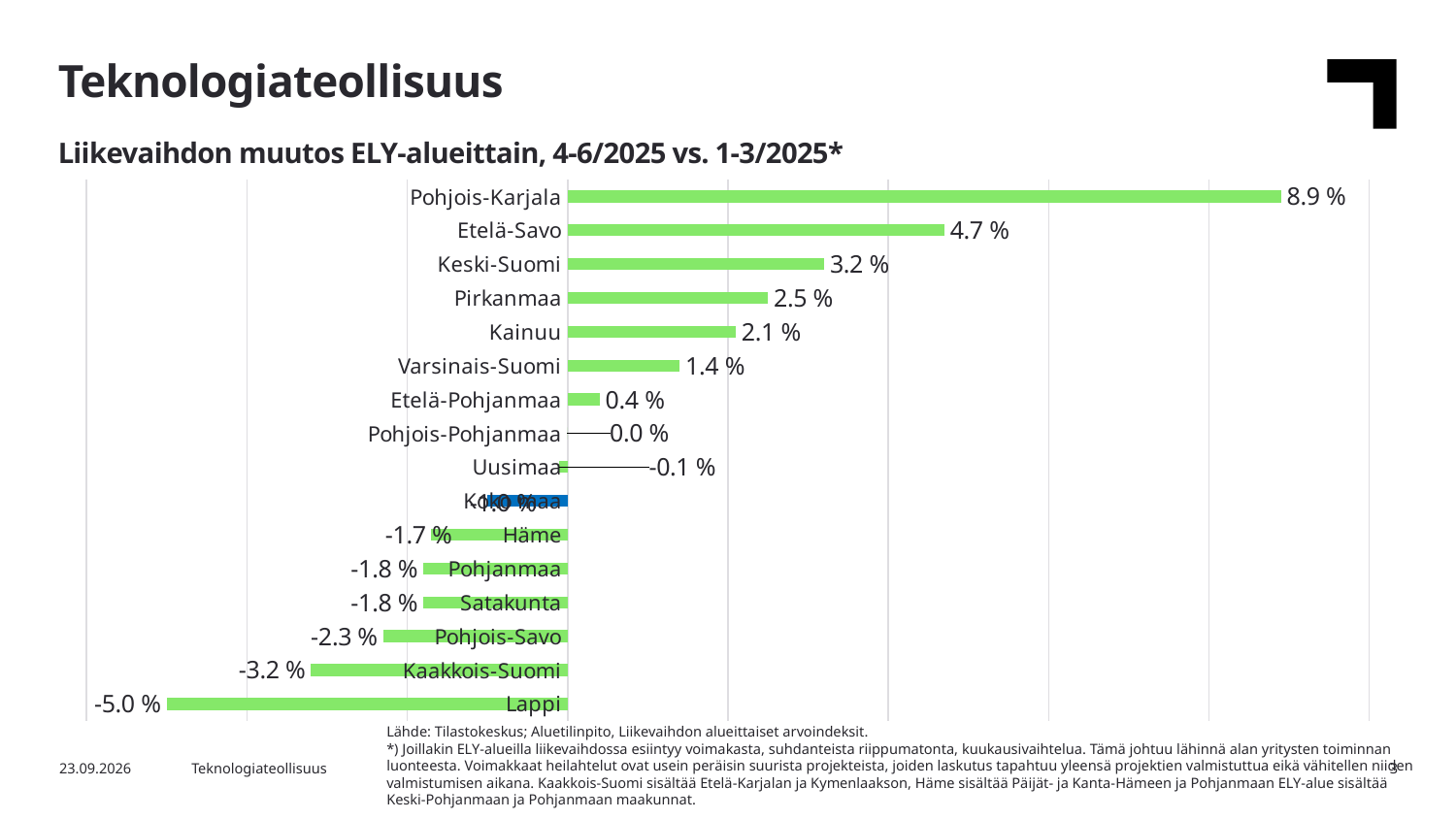
What is the value for Uusimaa? -0.1 % Which ELY area has the lowest value? Lappi Which ELY area has the highest value? Pohjois-Karjala Which has a larger value, Pirkanmaa or Kainuu? Pirkanmaa What is the difference between the values for Pohjois-Karjala and Etelä-Savo? 4.2 % What is the title of the chart? Liikevaihdon muutos ELY-alueittain, 4-6/2025 vs. 1-3/2025* What is the value for Kaakkois-Suomi? -3.2 % What is the value for Etelä-Savo? 4.7 % How many ELY areas (categories) are shown in the chart? 16 What is the value for Pohjois-Karjala? 8.9 % What is the value for Lappi? -5.0 % What kind of chart is shown on the slide? Bar chart